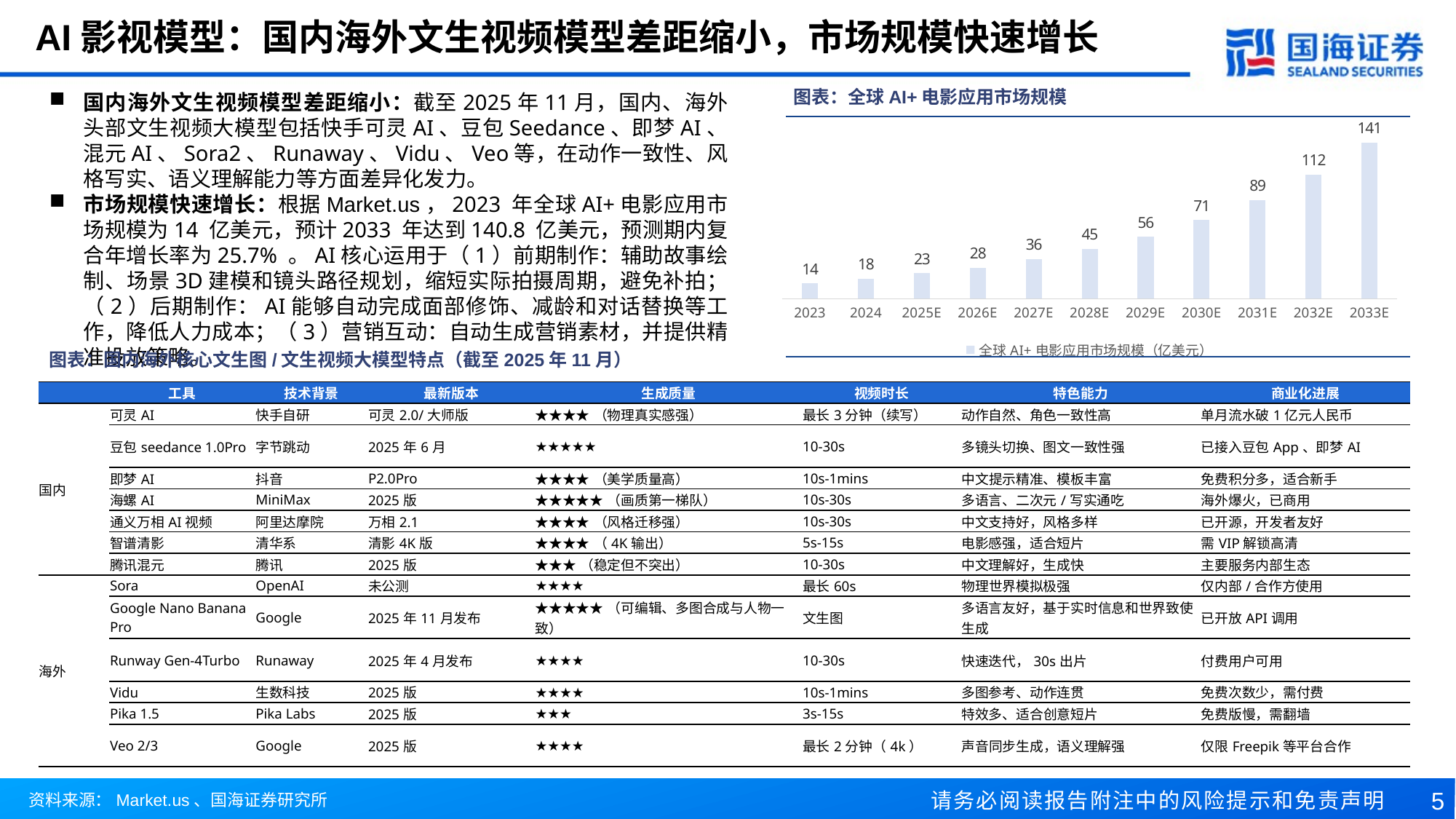
Do the values in the 全球 AI+ 电影应用市场规模 chart rise or fall from 2023 to 2033E? rise Which year has the highest value in the 全球 AI+ 电影应用市场规模 chart? 2033E What is the value for 2023 in the 全球 AI+ 电影应用市场规模 chart? 14 What is the value for 2033E in the 全球 AI+ 电影应用市场规模 chart? 141 How many years are shown on the x axis of the 全球 AI+ 电影应用市场规模 chart? 11 How many series does the legend of the 全球 AI+ 电影应用市场规模 chart list? 1 In the 全球 AI+ 电影应用市场规模 chart, which is larger, the value for 2027E or the value for 2029E? 2029E What kind of chart is the 全球 AI+ 电影应用市场规模 chart? bar chart What is the value for 2028E in the 全球 AI+ 电影应用市场规模 chart? 45 Which year has the lowest value in the 全球 AI+ 电影应用市场规模 chart? 2023 What is the difference between the values for 2033E and 2023 in the 全球 AI+ 电影应用市场规模 chart? 127 What is the value for 2030E in the 全球 AI+ 电影应用市场规模 chart? 71